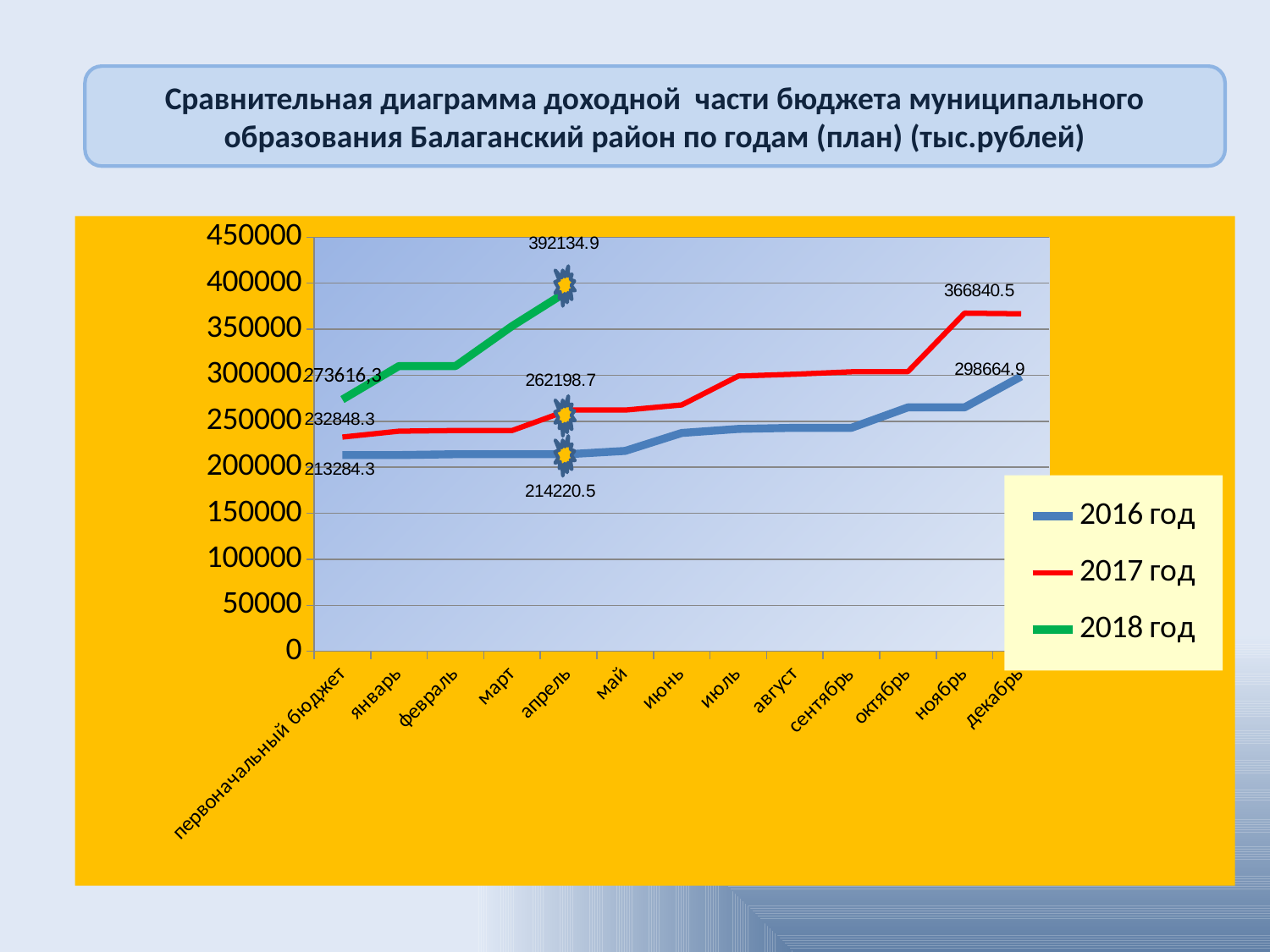
How many categories are shown along the x axis? 13 What kind of chart is shown on the slide? line chart What is the value labelled for 2016 год at декабрь? 298664.9 What is the value labelled for 2016 год at апрель? 214220.5 What is the value labelled for 2018 год at апрель? 392134.9 What is the difference between the 2018 год and 2017 год values labelled at апрель? 129936.2 Is the value for 2016 год in июль greater or less than 250000? less Does the 2016 год line rise or fall from первоначальный бюджет to декабрь? rise What is the value labelled for 2017 год at первоначальный бюджет? 232848.3 How many series does the legend list? 3 Which series has the highest value at апрель? 2018 год What is the difference between the 2017 год and 2016 год values labelled at первоначальный бюджет? 19564